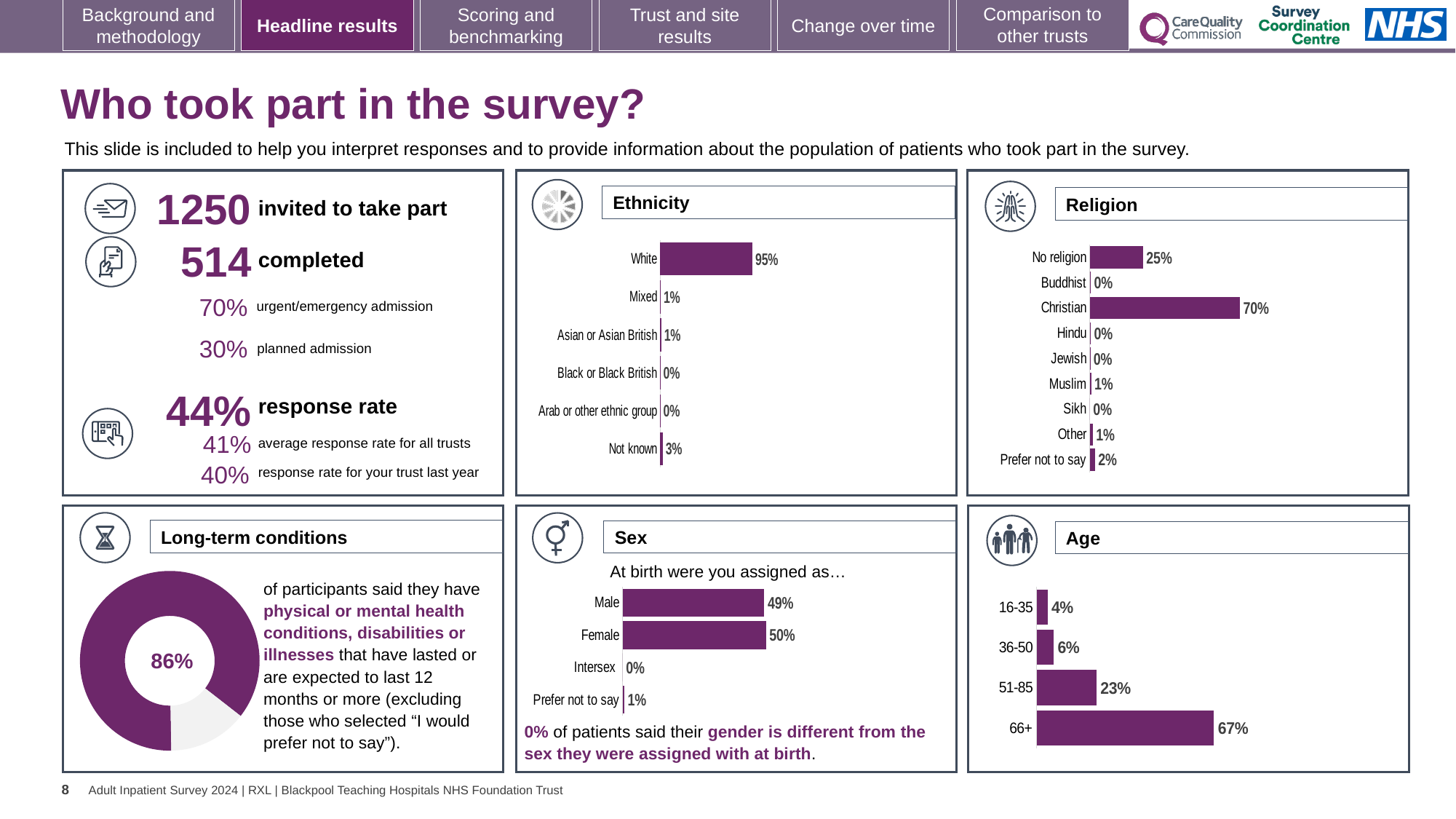
In the Religion chart, what is the difference between the Christian and No religion values? 45% In the Sex chart, what percentage of respondents selected Prefer not to say? 1% In the Religion chart, what is the value for No religion? 25% In the Sex chart, which is larger, the value for Male or the value for Female? Female In the Religion chart, which religion category has the highest value? Christian How many categories are shown in the Religion chart? 9 In the Ethnicity chart, what percentage of respondents were White? 95% What kind of chart is used in the Long-term conditions panel? Doughnut chart In the Ethnicity chart, what percentage of respondents were recorded as Not known? 3% In the Age chart, which age group has the highest value? 66+ In the Age chart, what is the value for the 51-85 age group? 23% In the Age chart, do the values rise or fall as the age groups increase from 16-35 to 66+? rise